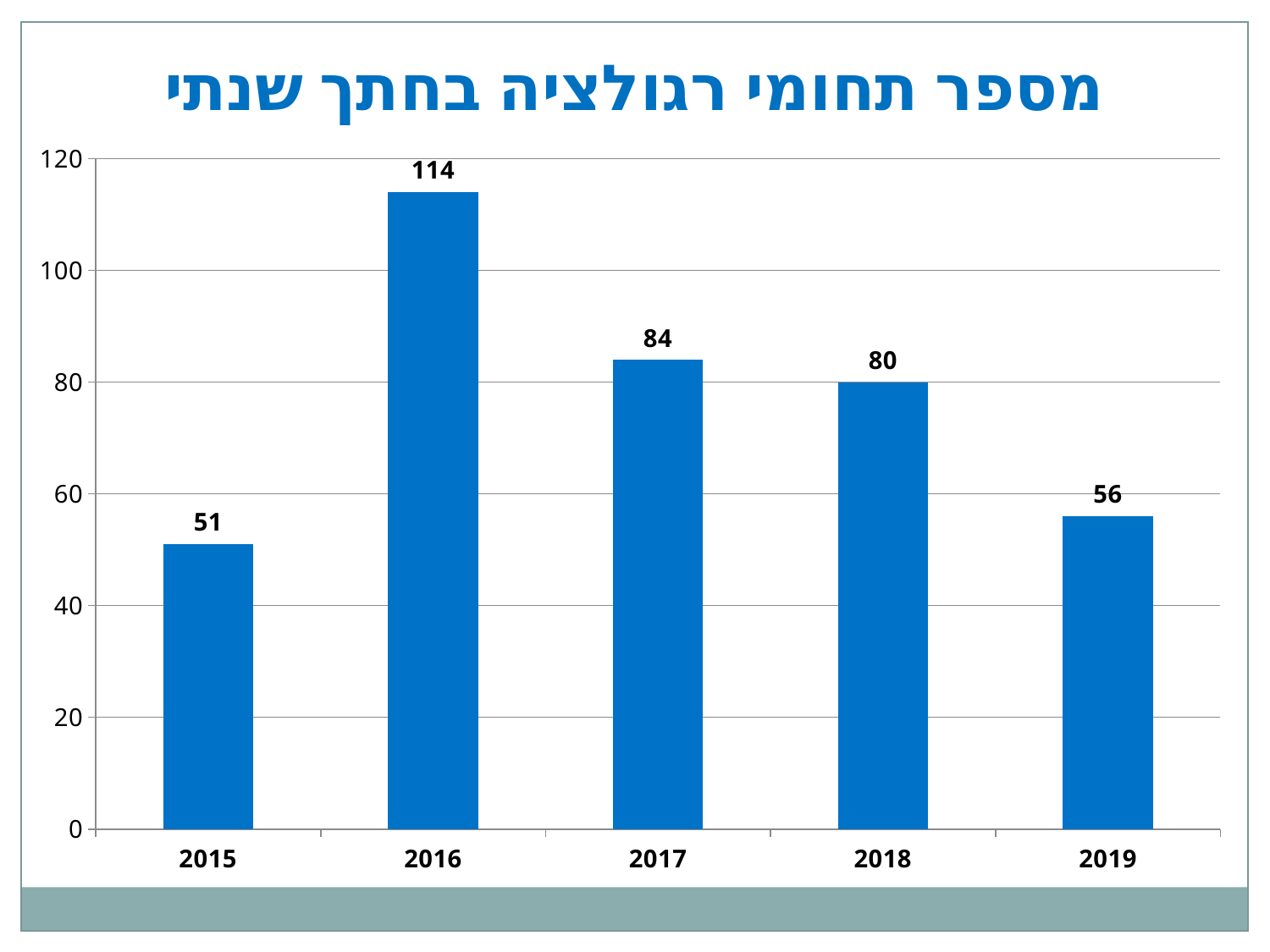
What is the value for 2015? 51 Which is larger, the value for 2017 or the value for 2018? 2017 What is the difference between the values for 2019 and 2015? 5 What is the value for 2016? 114 How many years are shown on the x axis? 5 Do the values rise or fall from 2016 to 2019? fall Which year has the lowest value? 2015 What is the value for 2019? 56 Which year has the highest value? 2016 What kind of chart is shown on the slide? bar chart Is the value for 2018 greater or less than 100? less What is the difference between the values for 2016 and 2017? 30